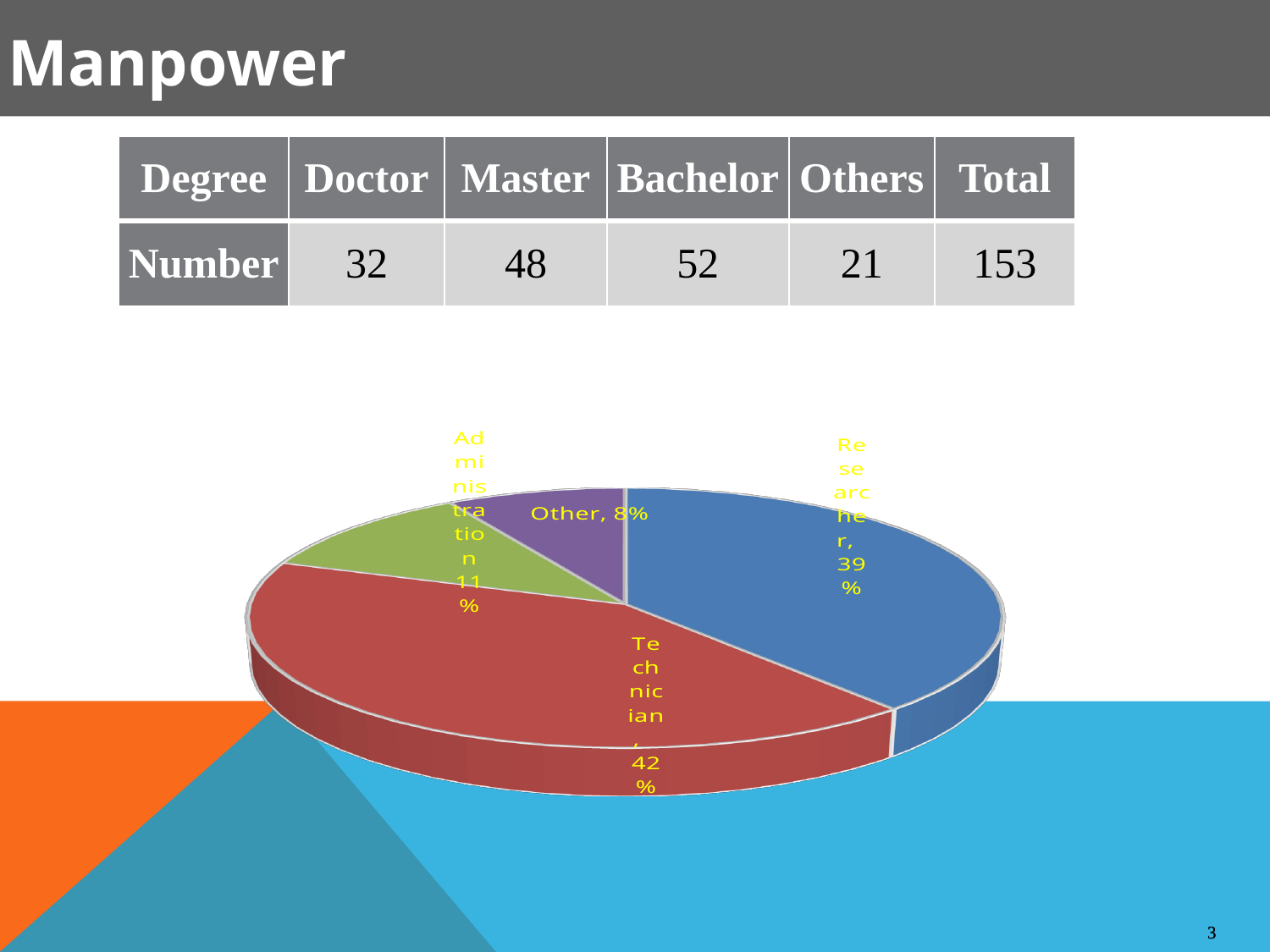
What share of the pie does Other represent? 8% What share of the pie does Technician represent? 42% What share of the pie does Administration represent? 11% Which category has the largest slice of the pie? Technician What share of the pie does Researcher represent? 39% Which slice is larger, Administration or Other? Administration What is the difference in percentage points between the Administration and Other slices? 3% What is the difference in percentage points between the Technician and Researcher slices? 3% How many slices does the pie chart have? 4 What type of chart is shown on the slide? pie chart What colour is the Technician slice of the pie? red Which category has the smallest slice of the pie? Other